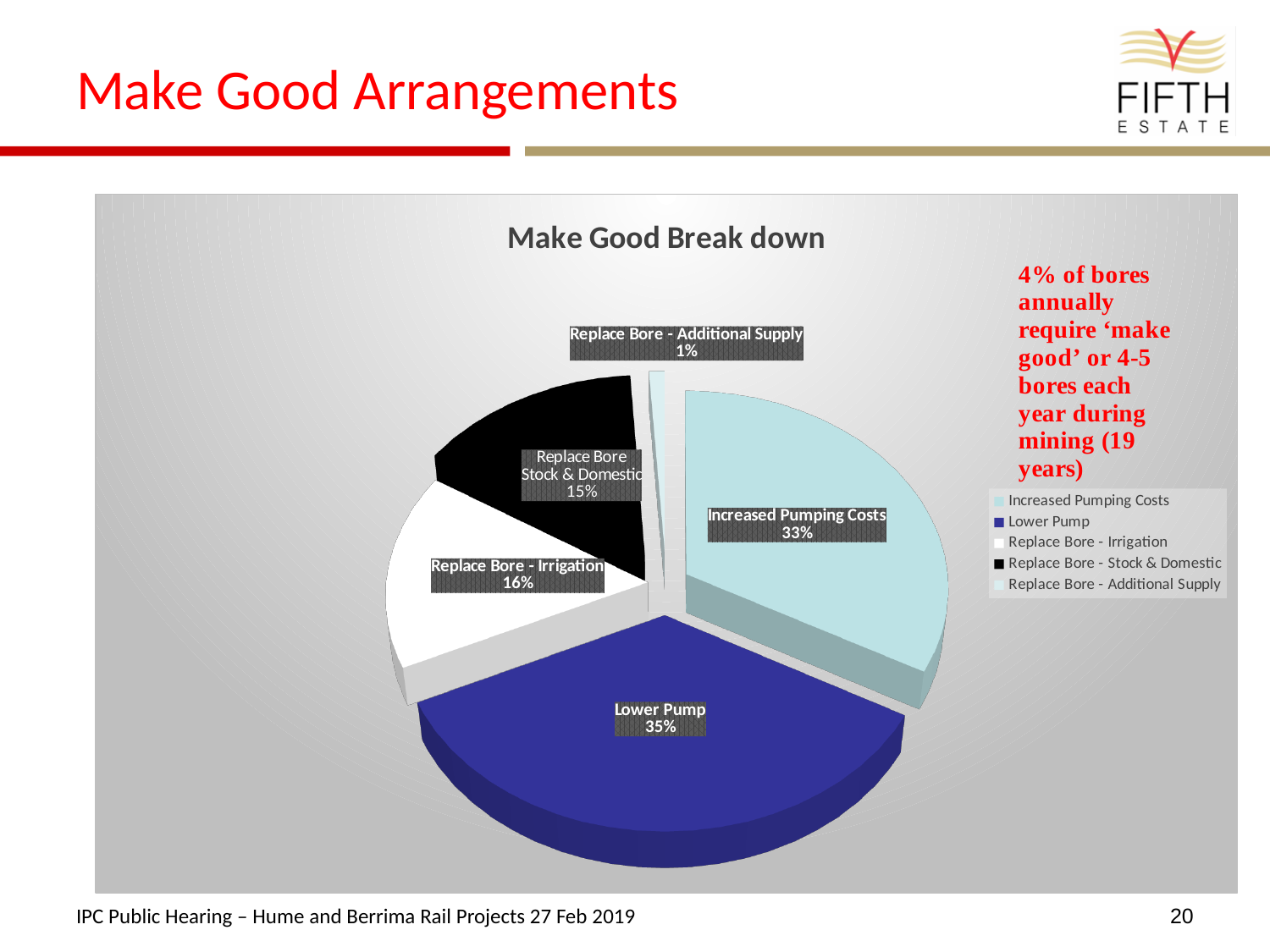
Which is larger, Replace Bore - Irrigation or Replace Bore - Stock & Domestic? Replace Bore - Irrigation What share of the pie is Replace Bore - Stock & Domestic? 15% What share of the pie is Replace Bore - Irrigation? 16% Which category has the largest share of the pie? Lower Pump What kind of chart is shown on the slide? pie chart What share of the pie is Lower Pump? 35% What share of the pie is Replace Bore - Additional Supply? 1% What is the title of the chart? Make Good Break down How many categories does the pie chart show? 5 What is the difference in percentage points between Lower Pump and Replace Bore - Stock & Domestic? 20 Which category has the smallest share of the pie? Replace Bore - Additional Supply What share of the pie is Increased Pumping Costs? 33%